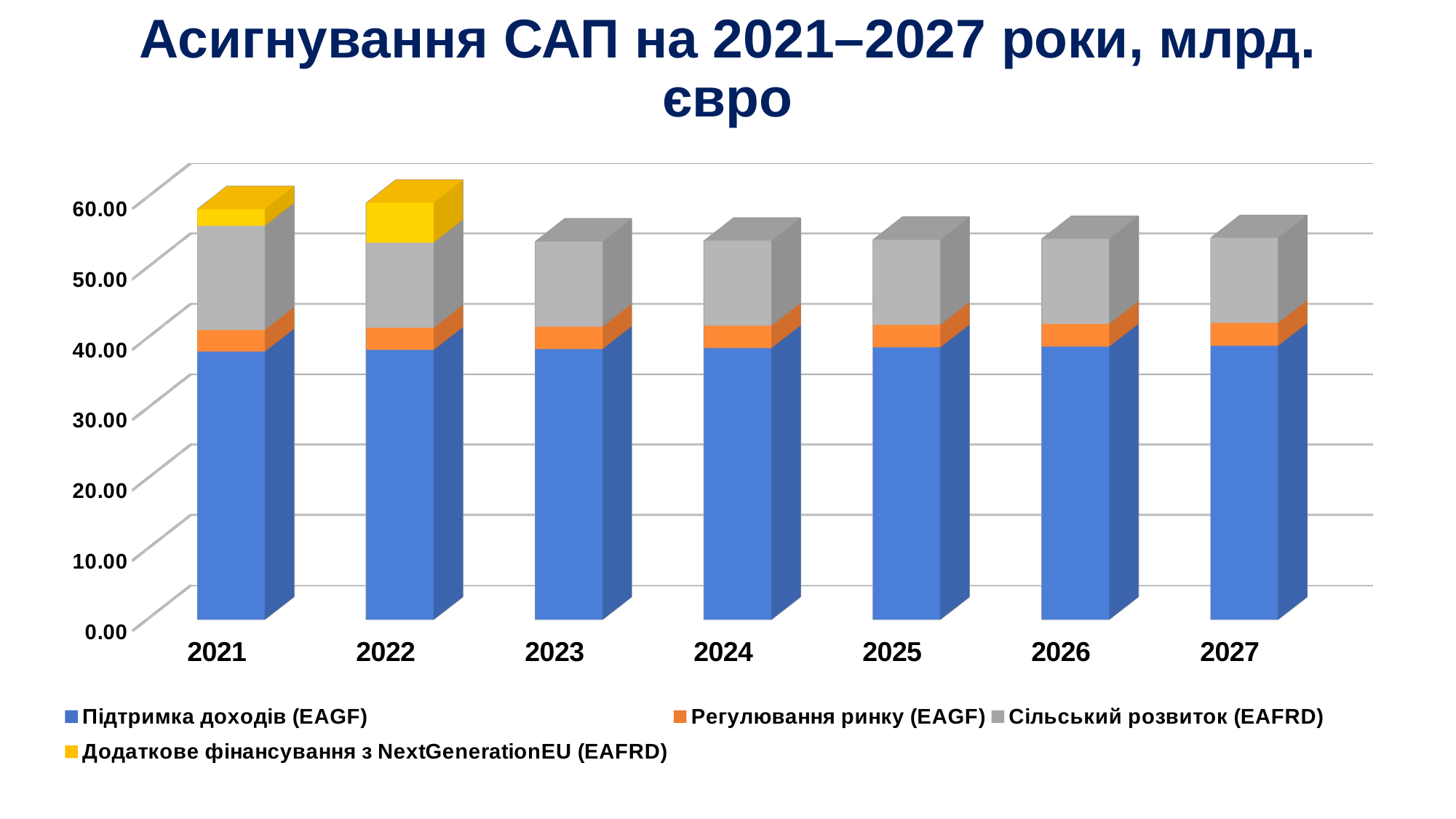
Is the value of Підтримка доходів (EAGF) for 2027 greater or less than 30.00? greater Which series is shown in yellow in the legend? Додаткове фінансування з NextGenerationEU (EAFRD) How many series does the legend list? 4 Which series forms the largest segment of each stacked bar? Підтримка доходів (EAGF) Which stacked bar is taller in total, 2022 or 2025? 2022 In which years does the bar include a yellow segment (Додаткове фінансування з NextGenerationEU)? 2021 and 2022 Is the total of the stacked bar for 2023 greater or less than 60.00? less What kind of chart is shown on the slide? Stacked bar chart Is the value of Підтримка доходів (EAGF) for 2024 greater or less than 50.00? less What is the title of the chart? Асигнування САП на 2021–2027 роки, млрд. євро How many years are shown on the x axis of the chart? 7